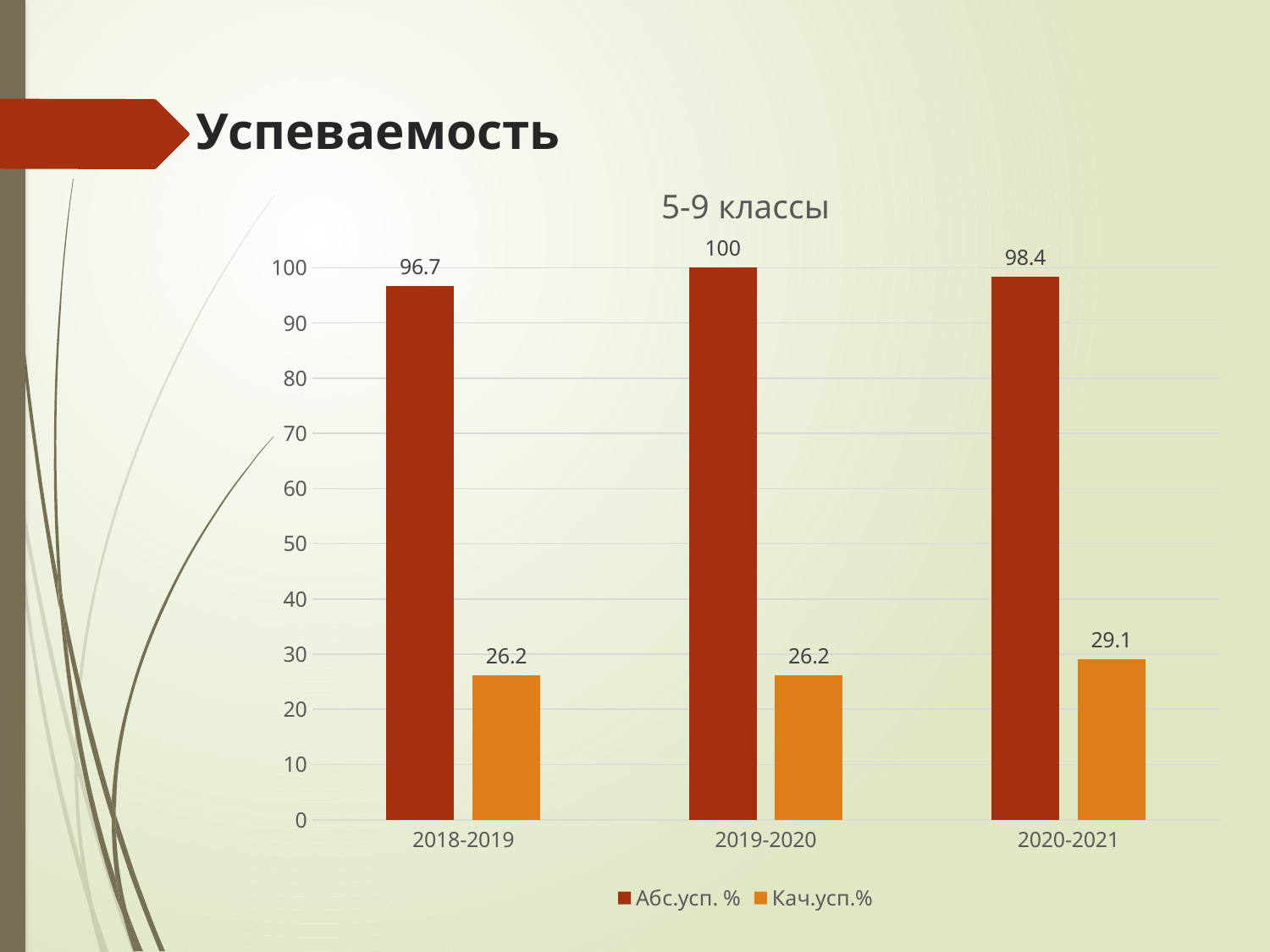
What is the value of Кач.усп.% for 2020-2021? 29.1 Which year has the lowest Абс.усп. % value? 2018-2019 Which is larger: Абс.усп. % for 2020-2021 or Абс.усп. % for 2018-2019? 2020-2021 How many series does the legend list? 2 What kind of chart is shown on the slide? Bar chart What is the value of Абс.усп. % for 2018-2019? 96.7 What is the difference between Абс.усп. % for 2019-2020 and 2018-2019? 3.3 What is the title of the chart? 5-9 классы What is the value of Абс.усп. % for 2019-2020? 100 Which year has the highest Абс.усп. % value? 2019-2020 What is the difference between Кач.усп.% for 2020-2021 and 2019-2020? 2.9 How many year categories are shown on the x axis? 3